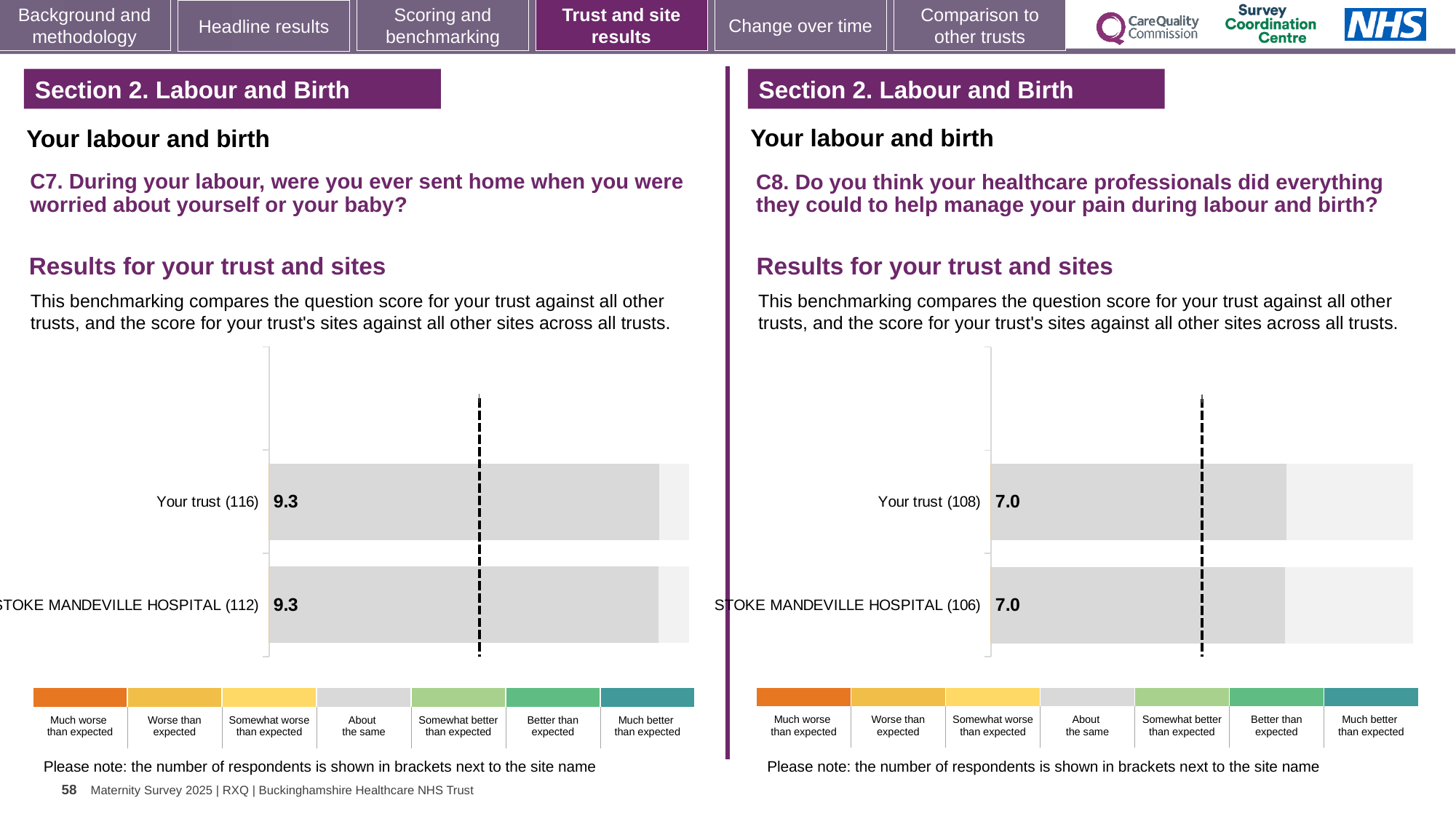
On the C8 chart (right), is the score for Your trust the same as or different from the score for Stoke Mandeville Hospital? The same How many categories does the colour key below the C7 chart (left) list? 7 On the C8 chart (right), what is the score for Your trust? 7.0 On the C8 chart (right), what is the score for Stoke Mandeville Hospital? 7.0 On the C7 chart (left), what is the difference between the score for Your trust and the score for Stoke Mandeville Hospital? 0.0 On the C7 chart (left), what is the score for Your trust? 9.3 On the C8 chart (right), how many respondents are shown in brackets for Stoke Mandeville Hospital? 106 On the C7 chart (left), what is the score for Stoke Mandeville Hospital? 9.3 What kind of chart is used on the C8 chart (right)? Bar chart On the C7 chart (left), how many bars are plotted? 2 On the C7 chart (left), how many respondents are shown in brackets for Your trust? 116 What is the label of the rightmost category in the colour key below the C8 chart (right)? Much better than expected